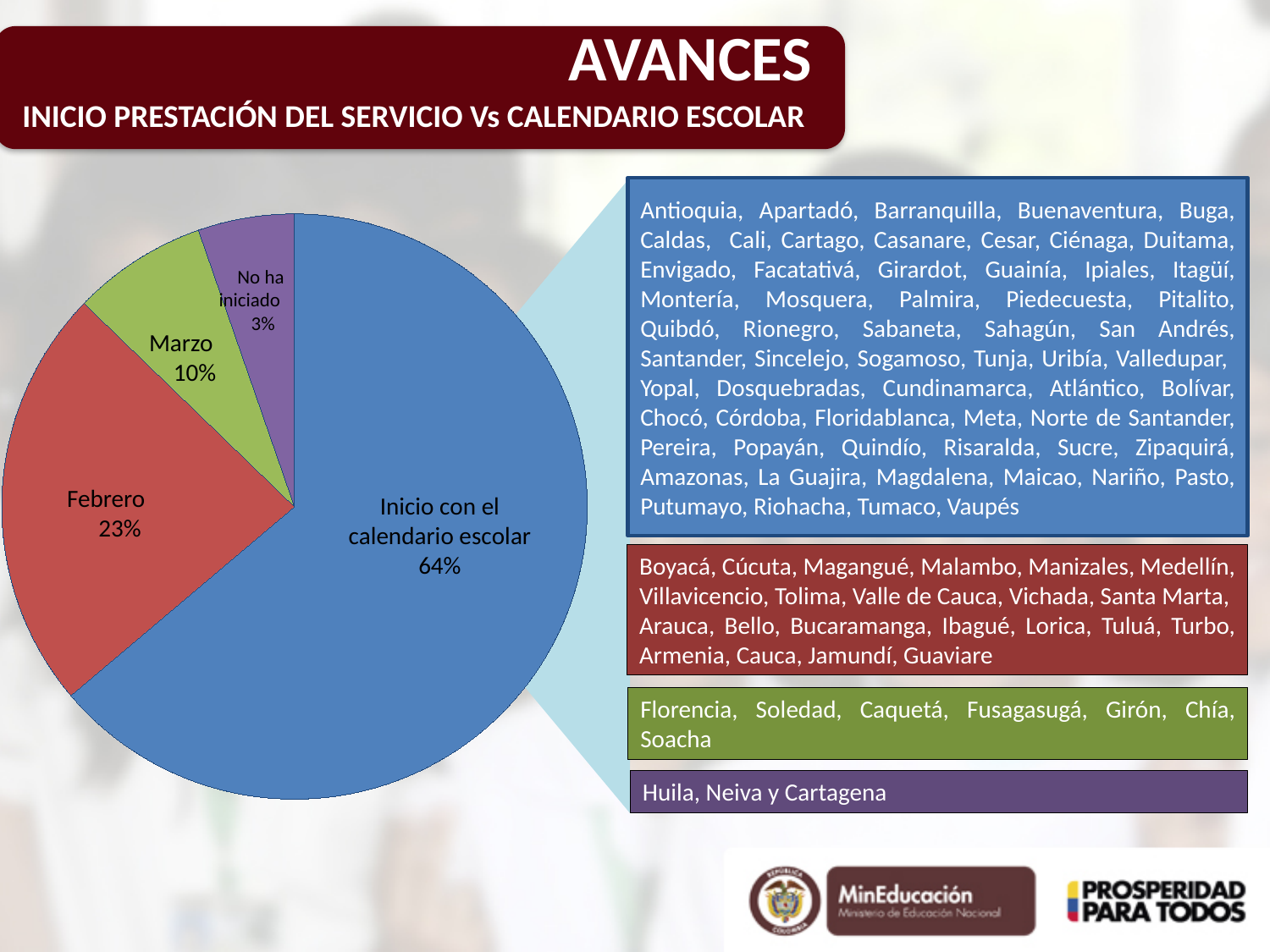
What is the value shown for the "Marzo" slice? 10% Which slice of the pie is the smallest? No ha iniciado What is the difference in percentage points between "Inicio con el calendario escolar" and "Febrero"? 41 What kind of chart is shown on the slide? pie chart How many slices does the pie chart have? 4 Which slice of the pie is the largest? Inicio con el calendario escolar What is the value shown for the "No ha iniciado" slice? 3% What share of the pie does "Inicio con el calendario escolar" represent? 64% What colour is the "Febrero" slice of the pie? red What is the value shown for the "Febrero" slice? 23% What is the difference in percentage points between the "Febrero" and "Marzo" slices? 13 Which is larger, the "Marzo" slice or the "No ha iniciado" slice? Marzo